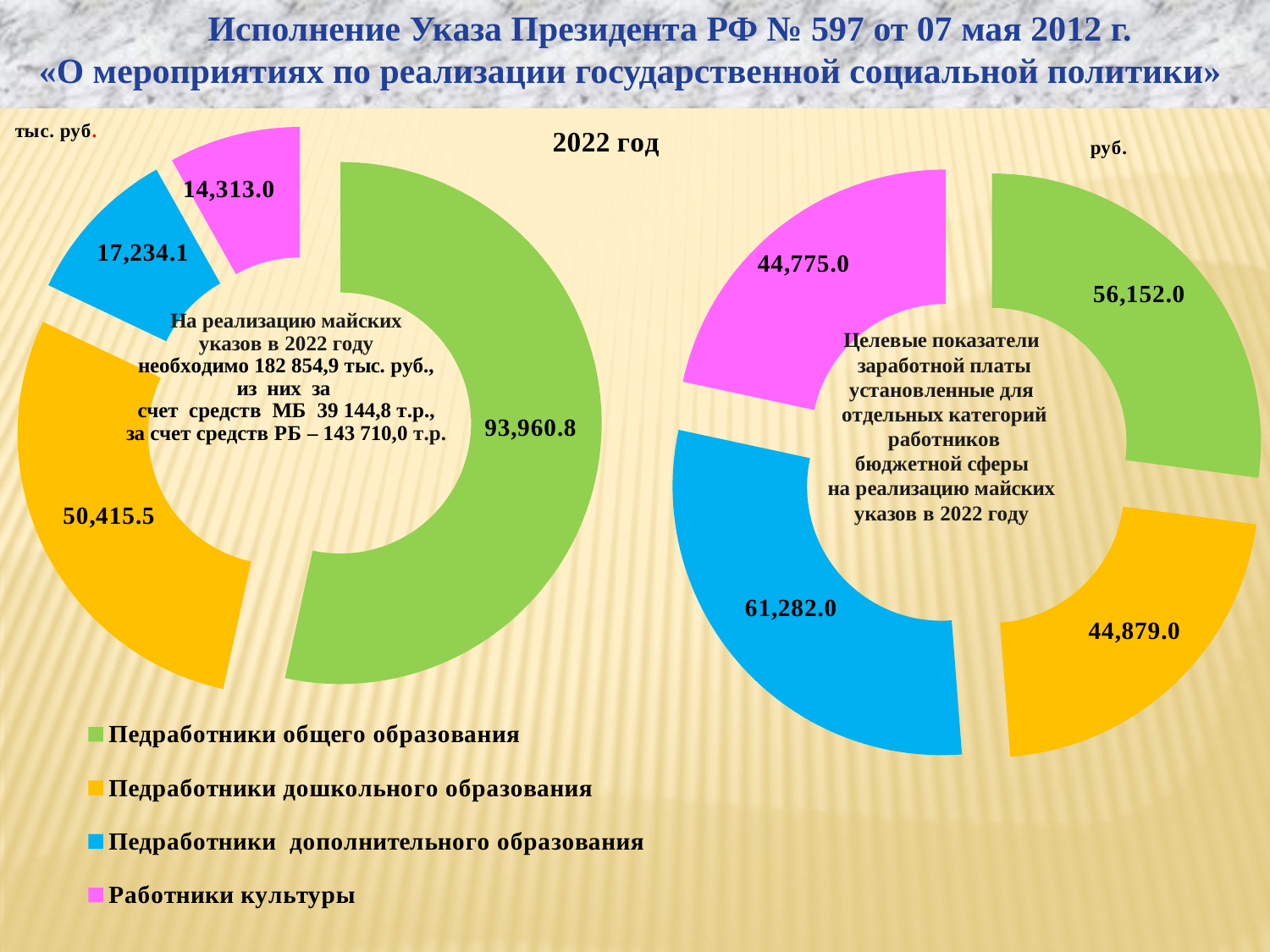
In the left chart (тыс. руб.), which is larger: Педработники дополнительного образования or Работники культуры? Педработники дополнительного образования In the left chart (тыс. руб.), which category has the smallest value? Работники культуры How many categories does the legend list? 4 In the right chart (руб.), which category has the largest value? Педработники дополнительного образования In the left chart (тыс. руб.), what is the difference between Педработники общего образования and Педработники дошкольного образования? 43,545.3 In the left chart (тыс. руб.), what is the value for Педработники общего образования? 93,960.8 In the left chart (тыс. руб.), what is the value for Педработники дошкольного образования? 50,415.5 In the left chart (тыс. руб.), what is the value for Работники культуры? 14,313.0 In the right chart (руб.), what is the value for Педработники общего образования? 56,152.0 In the left chart (тыс. руб.), which category has the largest value? Педработники общего образования What kind of chart is shown on the left side of the slide? Doughnut (pie) chart In the right chart (руб.), what is the value for Педработники дополнительного образования? 61,282.0